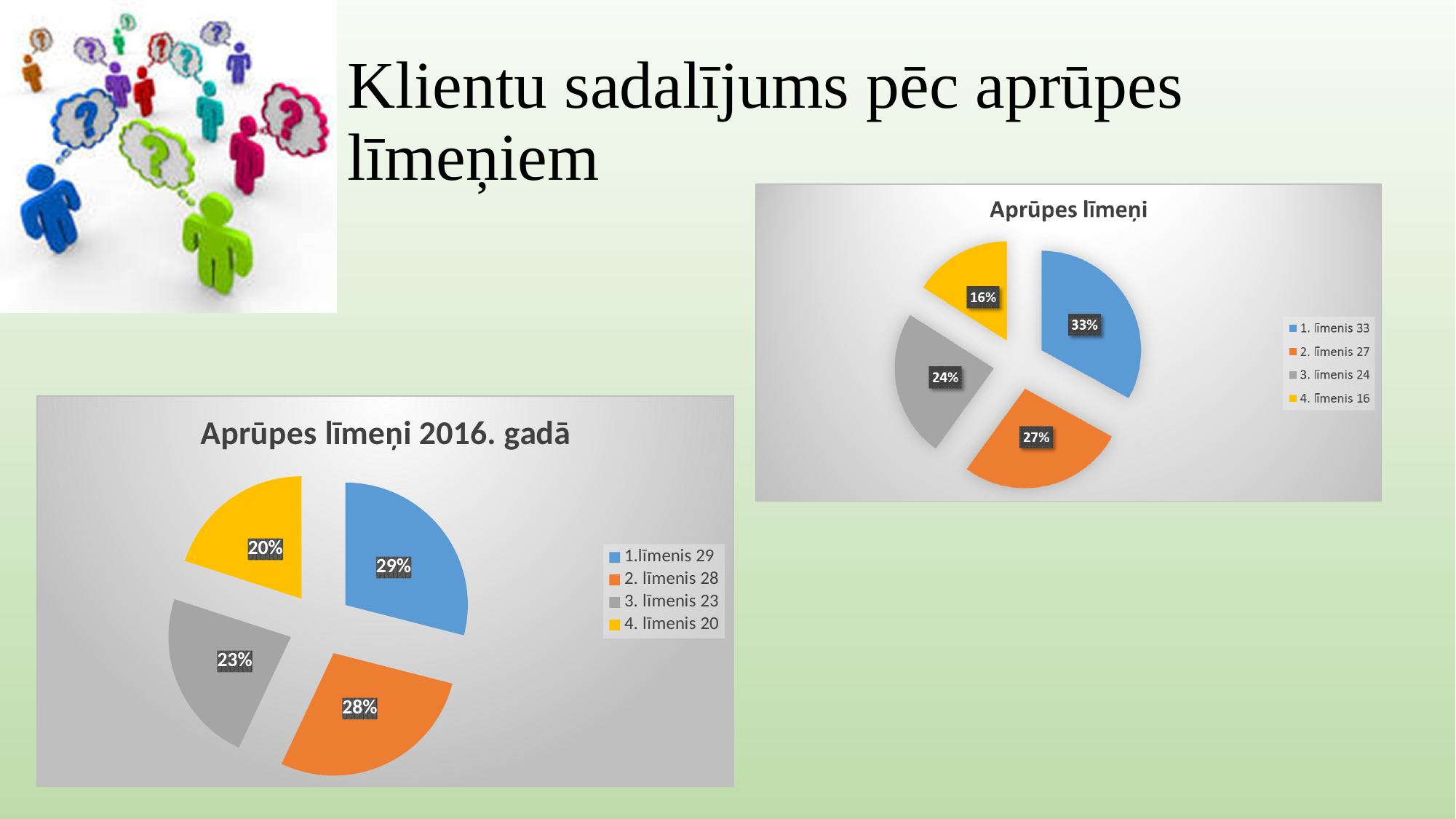
In the chart titled "Aprūpes līmeņi", what percentage is shown for 4. līmenis? 16% In the chart titled "Aprūpes līmeņi", which is larger, the slice for 2. līmenis or the slice for 3. līmenis? 2. līmenis In the chart titled "Aprūpes līmeņi", which category has the largest slice? 1. līmenis In the chart titled "Aprūpes līmeņi 2016. gadā", which category has the smallest slice? 4. līmenis In the chart titled "Aprūpes līmeņi 2016. gadā", what is the difference in percentage points between 2. līmenis and 3. līmenis? 5 In the chart titled "Aprūpes līmeņi", what share of the pie does 1. līmenis have? 33% In the chart titled "Aprūpes līmeņi 2016. gadā", how many slices does the pie have? 4 In the chart titled "Aprūpes līmeņi", what is the difference in percentage points between 1. līmenis and 4. līmenis? 17 In the chart titled "Aprūpes līmeņi", what colour is the slice for 3. līmenis? Grey In the chart titled "Aprūpes līmeņi 2016. gadā", what percentage is shown for 4. līmenis? 20% What kind of chart is the one titled "Aprūpes līmeņi" on the right of the slide? Pie chart In the chart titled "Aprūpes līmeņi 2016. gadā", what share of the pie does 1.līmenis have? 29%